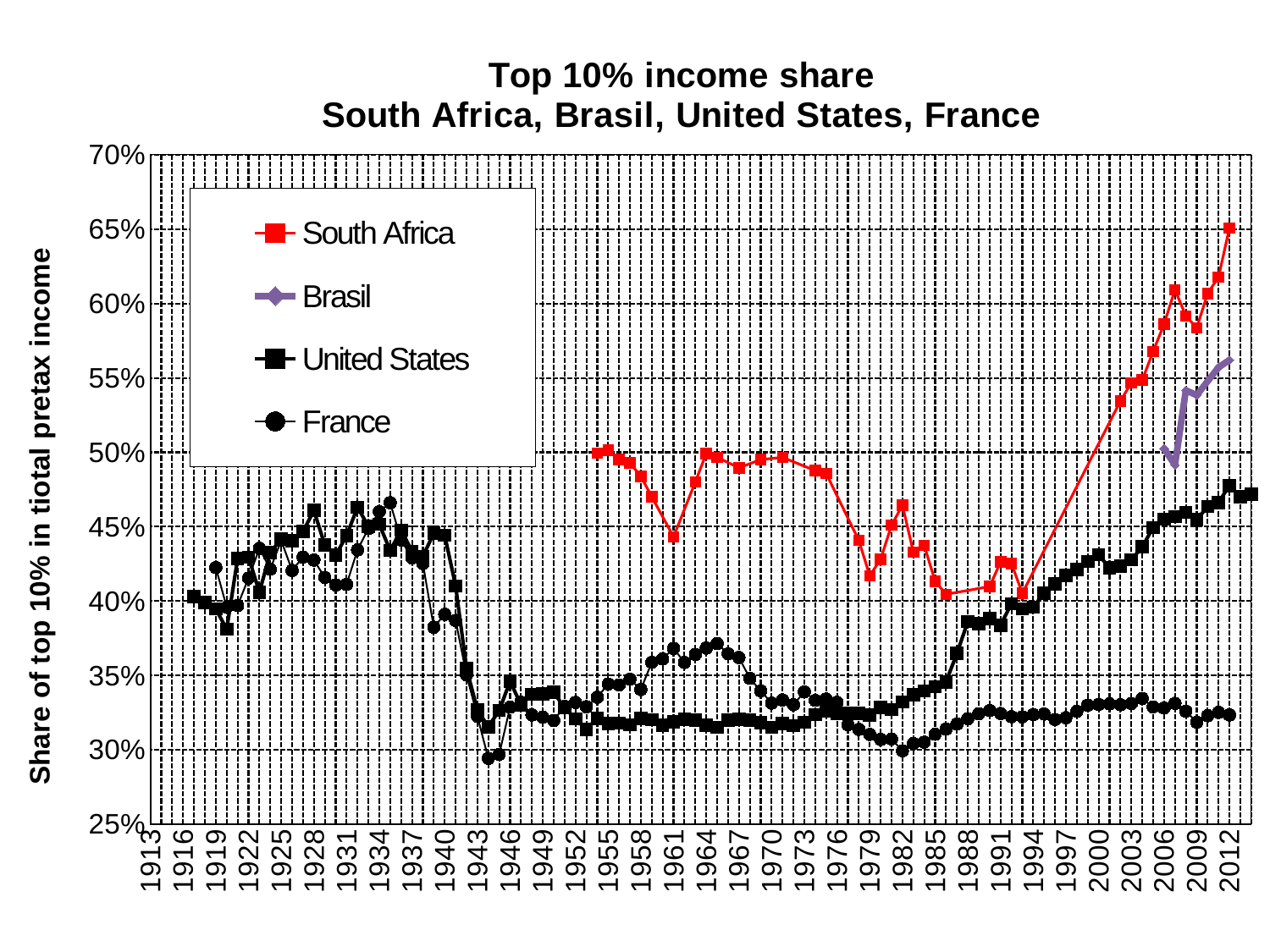
Is the value for the United States in 1943 greater or less than 35%? less What kind of chart is shown on the slide? line chart In 1979, which series has the higher value, South Africa or France? South Africa In 2012, which series has the higher value, South Africa or United States? South Africa How many series does the legend list? 4 Which series reaches the highest value anywhere on the chart? South Africa Does the South Africa series rise or fall between 1994 and 2012? rise Is the value for South Africa in 2012 greater or less than 60%? greater Is the value for France in 2012 greater or less than 35%? less Which colour is used for the South Africa series? red What is the title of the chart? Top 10% income share South Africa, Brasil, United States, France